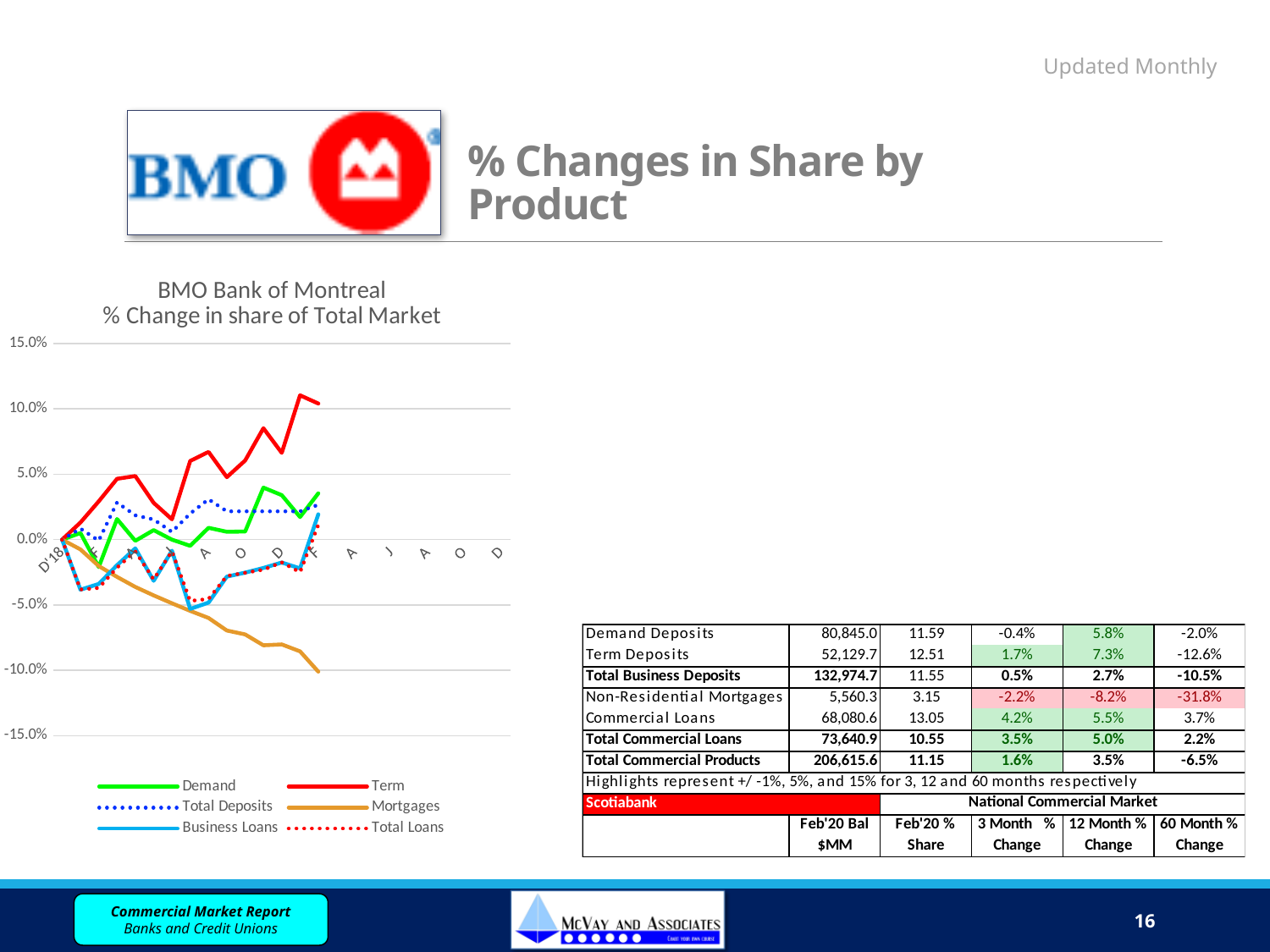
Which series has the highest value at the right end of the chart? Term What is the title of the chart? BMO Bank of Montreal % Change in share of Total Market Does the Term series rise or fall overall along the x axis? Rise Is the final value of the Mortgages series greater or less than -5.0%? less Which series is plotted with an orange line? Mortgages Does the Mortgages series rise or fall along the x axis? Fall Which series has the lowest value at the right end of the chart? Mortgages Is the peak value of the Term series greater or less than 10.0%? greater At the right end of the chart, which is larger: the Term series or the Demand series? Term What kind of chart is shown on the slide? Line chart Is the final value of the Demand series greater or less than 0.0%? greater How many series does the chart legend list? 6